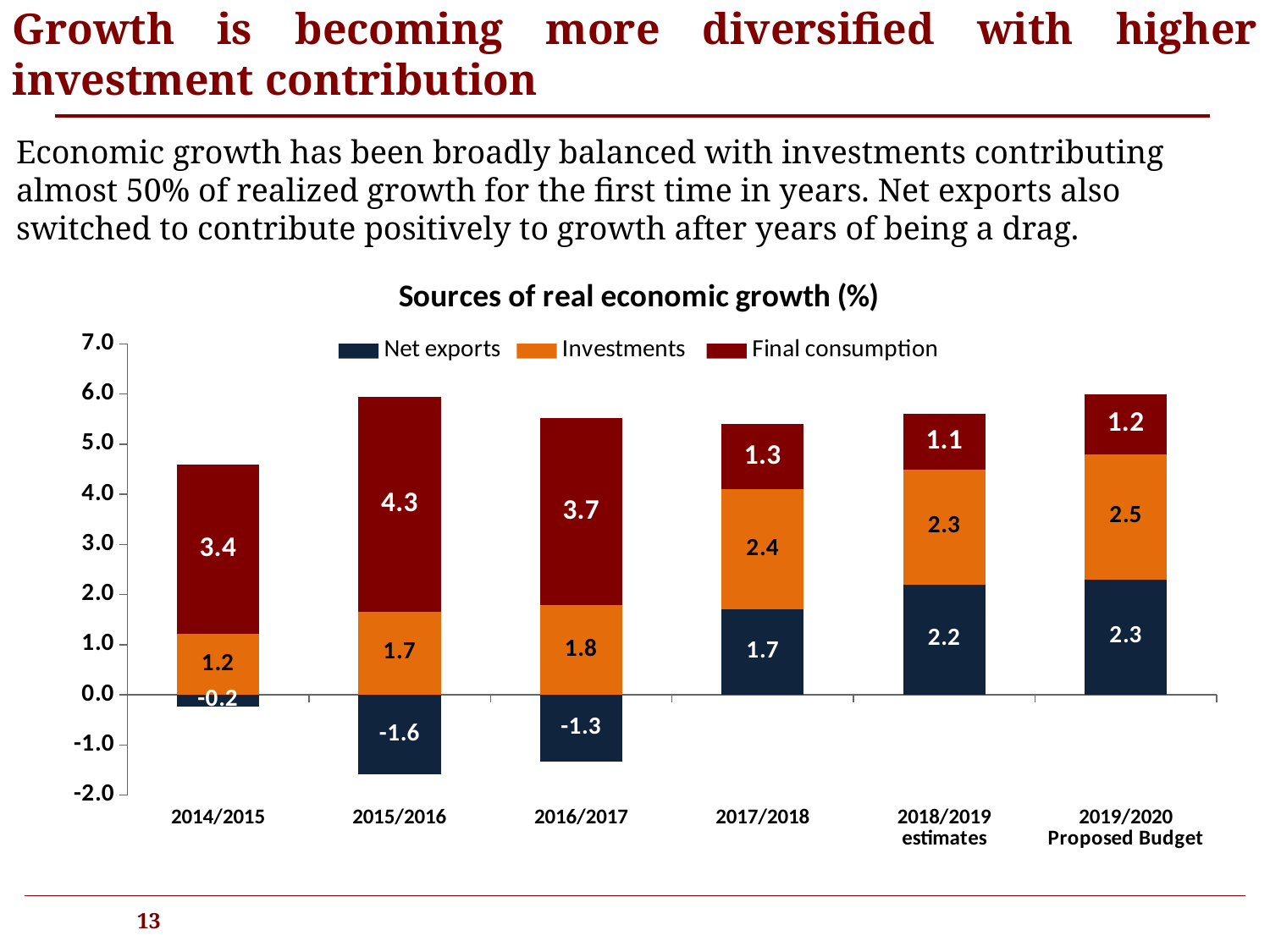
How many years are shown on the x axis? 6 What is the difference between Final consumption in 2015/2016 and in 2014/2015? 0.9 In which year is the Net exports contribution lowest? 2015/2016 What is the value for Net exports in 2016/2017? -1.3 In which year is the Final consumption contribution highest? 2015/2016 How many series does the legend list? 3 What is the total of the stacked bar for the 2019/2020 Proposed Budget? 6.0 What is the total of the stacked bar for 2017/2018? 5.4 What is the value for Investments in the 2019/2020 Proposed Budget? 2.5 What kind of chart is shown on the slide? Stacked bar chart What is the value for Final consumption in 2015/2016? 4.3 Which is larger in 2018/2019 estimates: Net exports or Investments? Investments